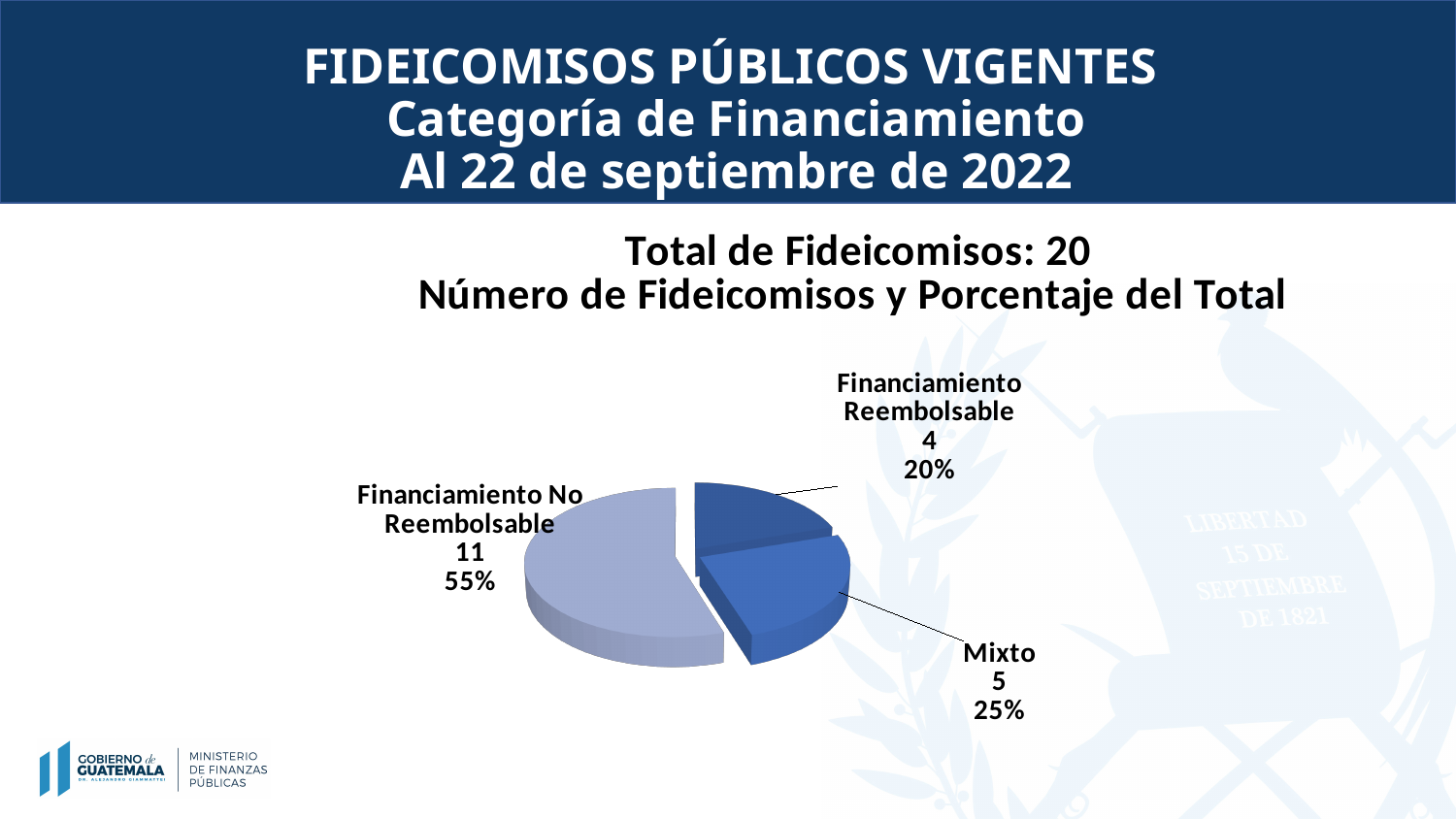
Which category has the largest number of fideicomisos? Financiamiento No Reembolsable What percentage of the total does Financiamiento Reembolsable represent? 20% What percentage of the total does the Mixto category represent? 25% How many categories does the pie chart show? 3 What is the total number of fideicomisos shown on the slide? 20 What is the difference in the number of fideicomisos between Financiamiento No Reembolsable and Mixto? 6 Which has more fideicomisos, Mixto or Financiamiento Reembolsable? Mixto How many fideicomisos are in the Financiamiento No Reembolsable category? 11 What kind of chart is shown on the slide? Pie chart What is the share of the total held by Financiamiento No Reembolsable? 55% How many fideicomisos are in the Mixto category? 5 Which category has the smallest number of fideicomisos? Financiamiento Reembolsable